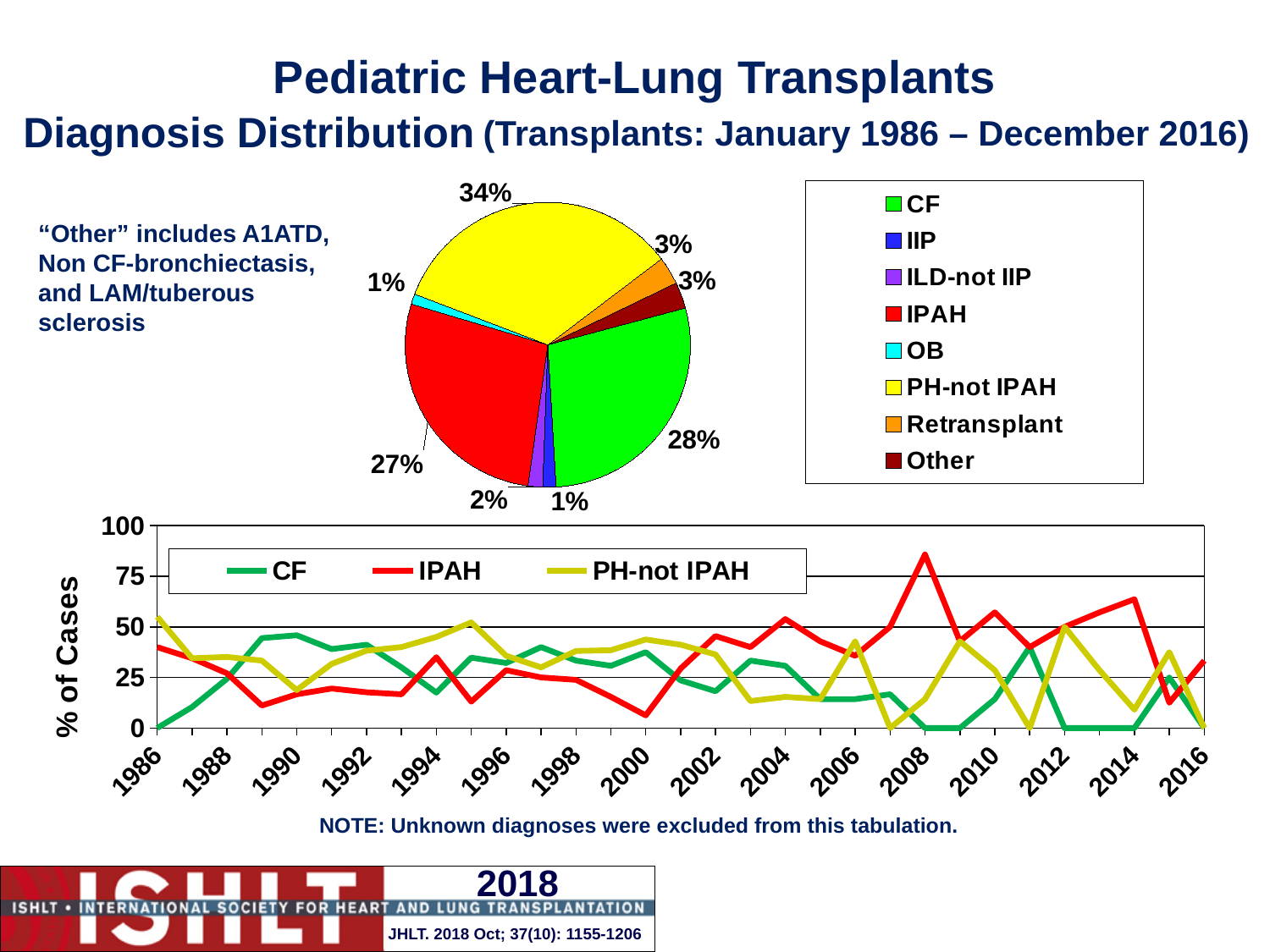
What kind of chart is the lower chart on the slide? Line chart In the pie chart, what percentage of cases is IPAH? 27% In the lower line chart, is the value for IPAH in 2008 greater or less than 75? greater In the pie chart, which is larger, the CF share or the IPAH share? CF How many series does the legend of the lower line chart list? 3 In the pie chart, which diagnosis has the largest share? PH-not IPAH In the pie chart, what percentage of cases is CF? 28% In the lower line chart, is the value for CF in 2009 greater or less than 25? less In the pie chart, what percentage of cases is PH-not IPAH? 34% In the pie chart, what colour represents IPAH? Red How many diagnosis categories does the pie chart legend list? 8 In the pie chart, what is the difference in percentage points between PH-not IPAH and IPAH? 7